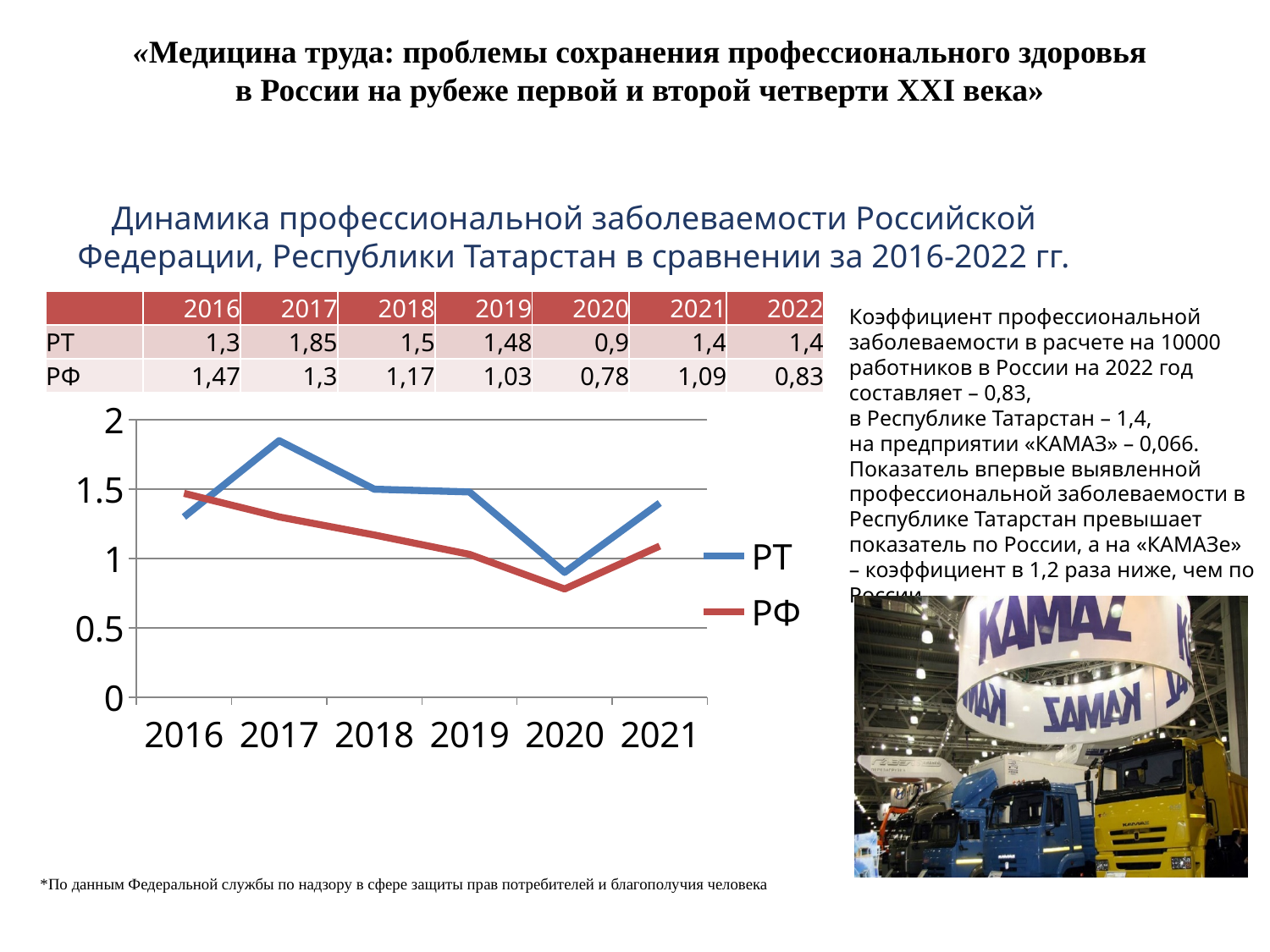
What is the value for РТ in 2017? 1,85 In which year does the РФ series reach its lowest value? 2020 What is the value for РТ in 2020? 0,9 What is the difference between the РТ and РФ values in 2017? 0,55 Does the РФ series rise or fall from 2016 to 2020? fall How many years are shown along the x axis of the chart? 6 Which series has the higher value in 2016, РТ or РФ? РФ In which year does the РТ series reach its highest value? 2017 What is the value for РФ in 2020? 0,78 Is the value for РТ in 2017 greater or less than 1.5? greater How many series does the chart legend list? 2 What type of chart is shown on the slide? line chart